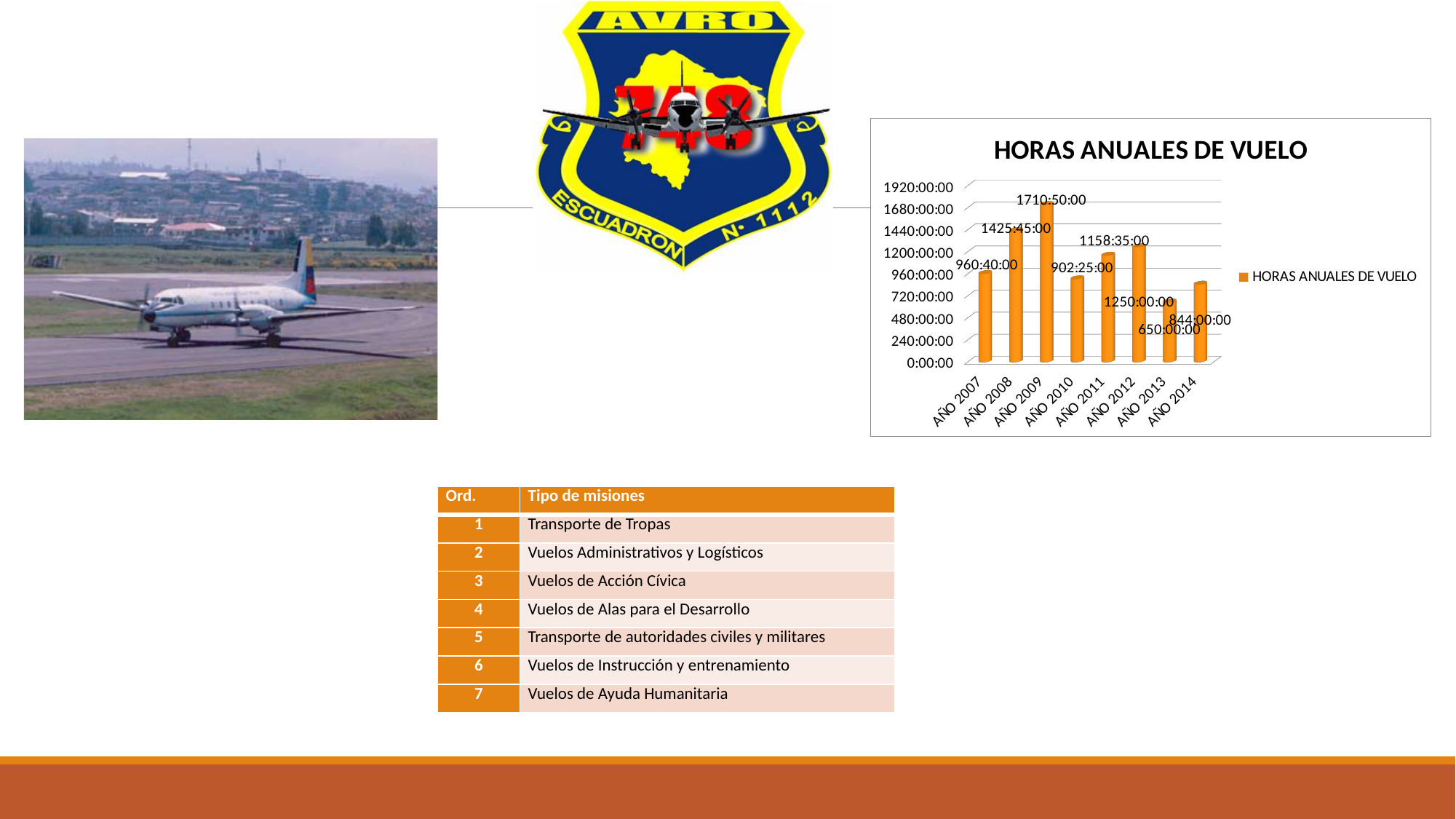
What is the value for AÑO 2009? 1710:50:00 Which is larger, the value for AÑO 2008 or AÑO 2011? AÑO 2008 What is the value for AÑO 2007? 960:40:00 What is the value for AÑO 2013? 650:00:00 What is the difference between the values for AÑO 2012 and AÑO 2013? 600:00:00 How many series does the chart legend list? 1 Which year has the lowest annual flight hours? AÑO 2013 Is the value for AÑO 2014 greater or less than 960:00:00? less Which year has the highest annual flight hours? AÑO 2009 What type of chart is shown on the slide? bar chart How many years are plotted in the chart? 8 What is the title of the chart? HORAS ANUALES DE VUELO